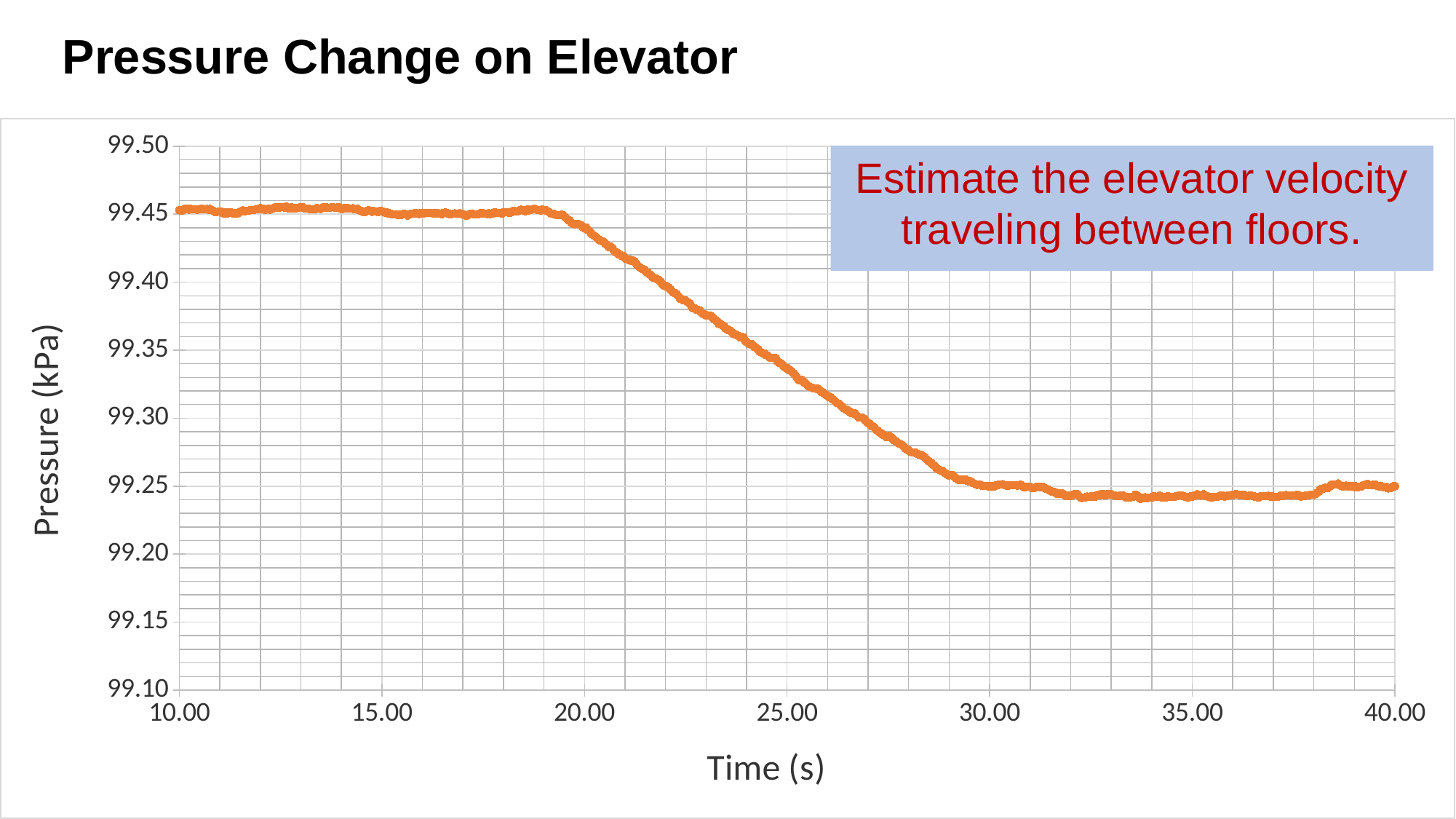
Is the pressure at 25.00 s greater or less than 99.30 kPa? greater What kind of chart is shown on the slide? line chart What is the label of the vertical axis? Pressure (kPa) Is the pressure at 25.00 s greater or less than 99.40 kPa? less Is the pressure at 35.00 s greater or less than 99.30 kPa? less What is the highest value shown on the vertical axis? 99.50 Overall, does the pressure rise or fall as time increases from 10.00 s to 40.00 s? fall Between which two x-axis tick values does the pressure drop most steeply? 20.00 and 30.00 Which is larger, the pressure at 15.00 s or the pressure at 35.00 s? 15.00 s What is the title of the chart? Pressure Change on Elevator